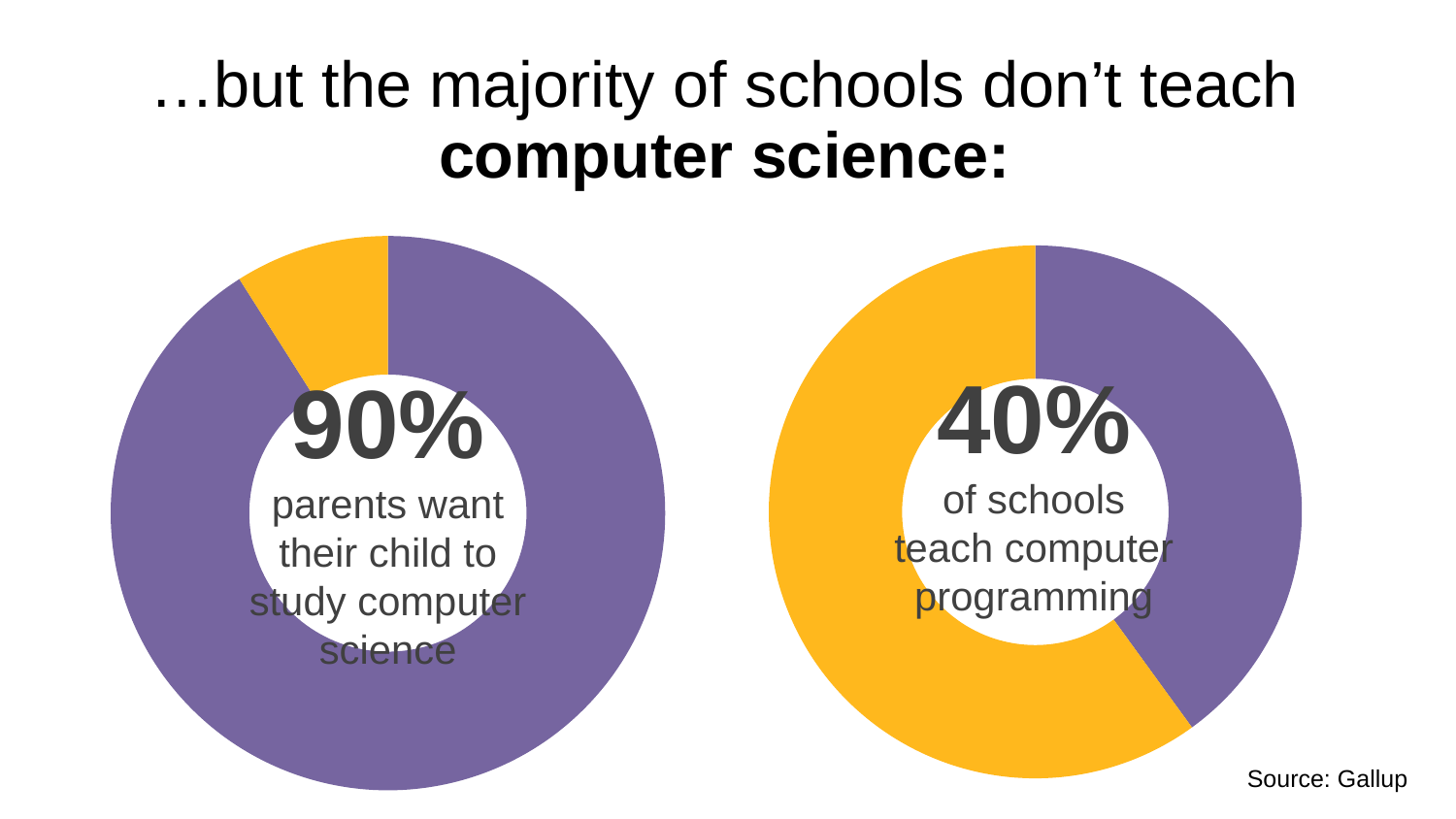
What kind of chart is used on the left of the slide? Donut (pie) chart What source is cited for the data on the slide? Gallup In the right chart, which colour occupies the larger share of the ring, purple or yellow? Yellow What colour is used for the 90% slice in the left chart? Purple In the right chart, is the purple slice greater or less than 50% of the ring? less Which chart shows the larger highlighted percentage, the left chart (parents) or the right chart (schools)? The left chart (parents) In the left chart, what percentage of parents want their child to study computer science? 90% How many donut charts are shown on the slide? 2 In the left chart, is the purple slice greater or less than 50% of the ring? greater What is the difference between the percentage of parents who want their child to study computer science and the percentage of schools that teach computer programming? 50 percentage points In the right chart, what percentage of schools teach computer programming? 40%